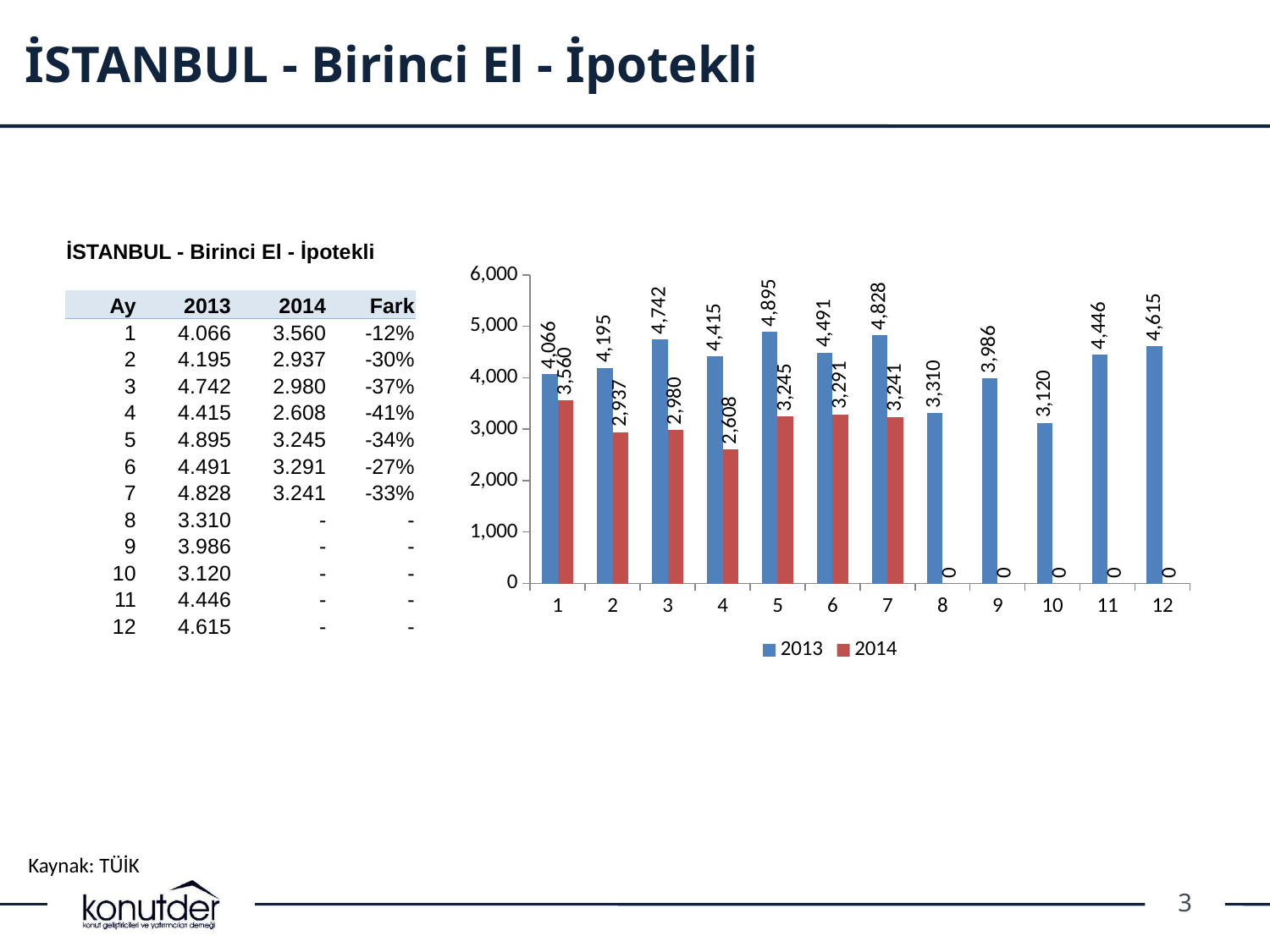
Is the value for 2013 in month 8 greater or less than 4,000? less What is the value for 2014 in month 4? 2,608 Which month has the highest value for the 2013 series? 5 How many months are shown on the x axis of the chart? 12 What is the value for 2013 in month 10? 3,120 How many series does the chart legend list? 2 What is the difference between the 2013 and 2014 values in month 1? 506 Which month has the lowest value for the 2013 series? 10 Which is larger in month 3: the 2013 value or the 2014 value? 2013 What kind of chart is shown on the slide? bar chart What is the value for 2013 in month 5? 4,895 Among months 1 to 7, which month has the lowest value for the 2014 series? 4